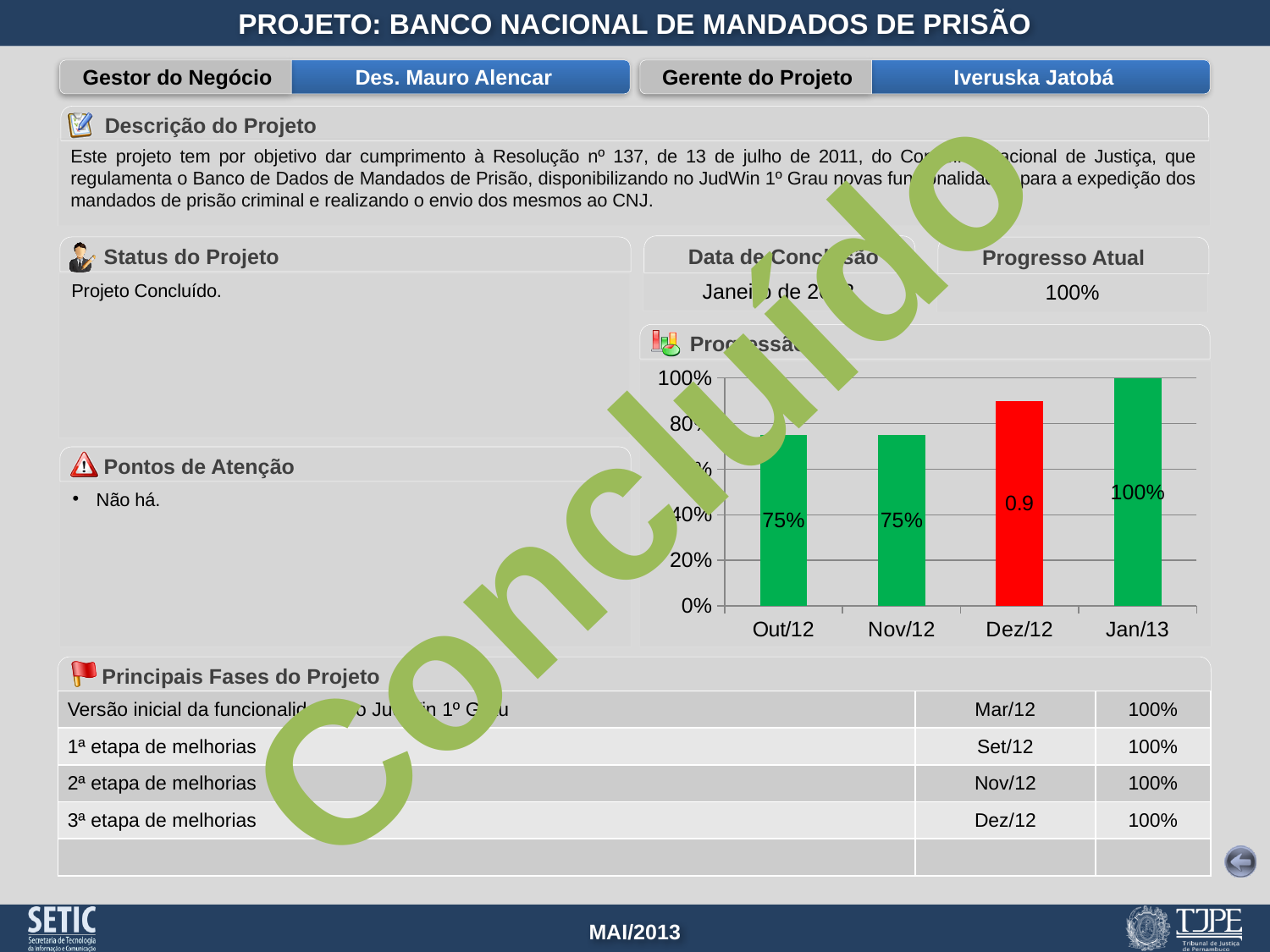
Which month has the highest bar in the chart? Jan/13 Is the value for Dez/12 greater or less than 80%? greater Which is larger, the value for Dez/12 or the value for Nov/12? Dez/12 What is the difference between the value for Jan/13 and the value for Out/12? 25% Do the values in the chart rise or fall from Out/12 to Jan/13? rise What colour is the Dez/12 bar in the chart? red What kind of chart is shown on the slide? bar chart What is the value shown for Nov/12 in the bar chart? 75% What data label is printed on the Dez/12 bar? 0.9 What is the value shown for Jan/13 in the bar chart? 100% How many months are plotted on the x axis of the chart? 4 What is the value shown for Out/12 in the bar chart? 75%